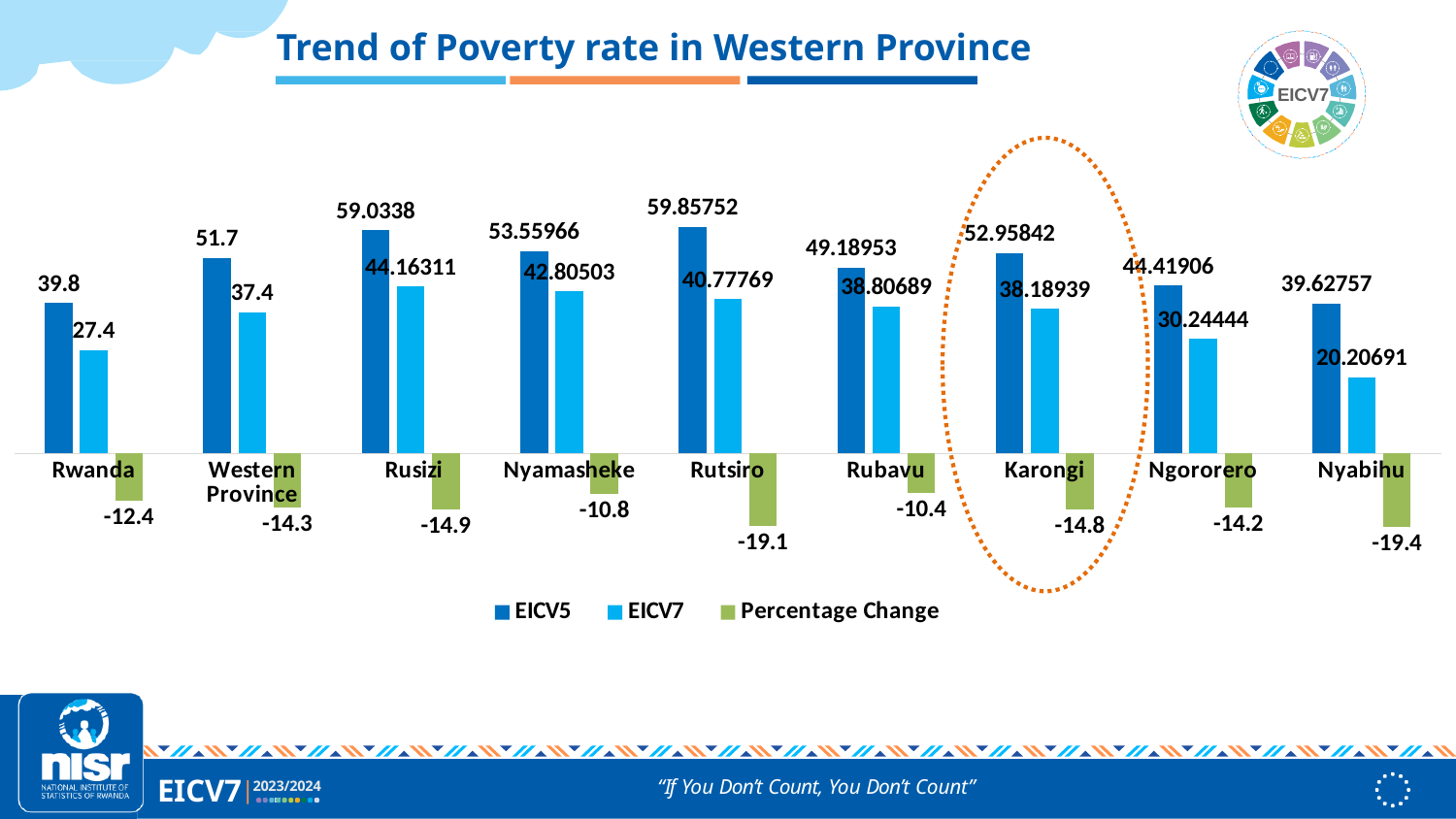
Which is larger, the EICV7 value for Rubavu or the EICV7 value for Ngororero? Rubavu What kind of chart is shown on the slide? Bar chart How many categories are shown on the x axis? 9 Which category has the highest EICV5 poverty rate? Rutsiro What is the Percentage Change value for Rutsiro? -19.1 What is the EICV7 poverty rate for Nyabihu? 20.20691 Which category is highlighted with a dotted orange oval? Karongi What is the EICV5 poverty rate for Rusizi? 59.0338 What is the difference between the EICV5 and EICV7 values for Rwanda? 12.4 Which category has the highest EICV7 poverty rate? Rusizi How many series does the legend list? 3 Which category has the lowest EICV7 poverty rate? Nyabihu